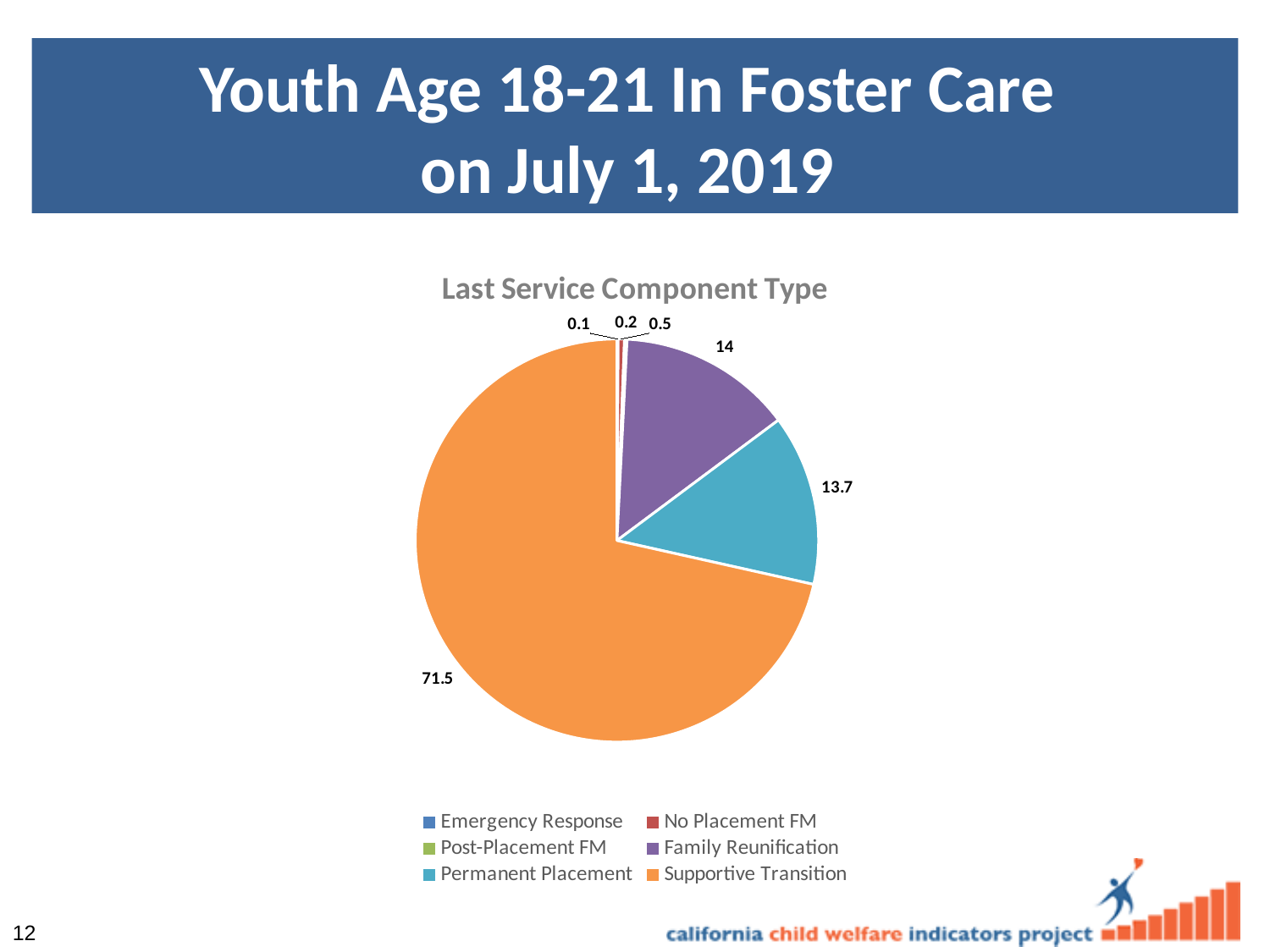
What is the difference between the values for Supportive Transition and Permanent Placement? 57.8 What colour is the Supportive Transition slice? Orange Which is larger, Family Reunification or Permanent Placement? Family Reunification How many service component types does the legend list? 6 What is the smallest value labelled on the pie chart? 0.1 Which service component type has the largest slice of the pie? Supportive Transition What is the difference between the values for Family Reunification and Permanent Placement? 0.3 What value is shown for Family Reunification? 14 What value is shown for Permanent Placement? 13.7 What is the title of the chart? Last Service Component Type What type of chart is shown on the slide? Pie chart What value is shown for Supportive Transition? 71.5